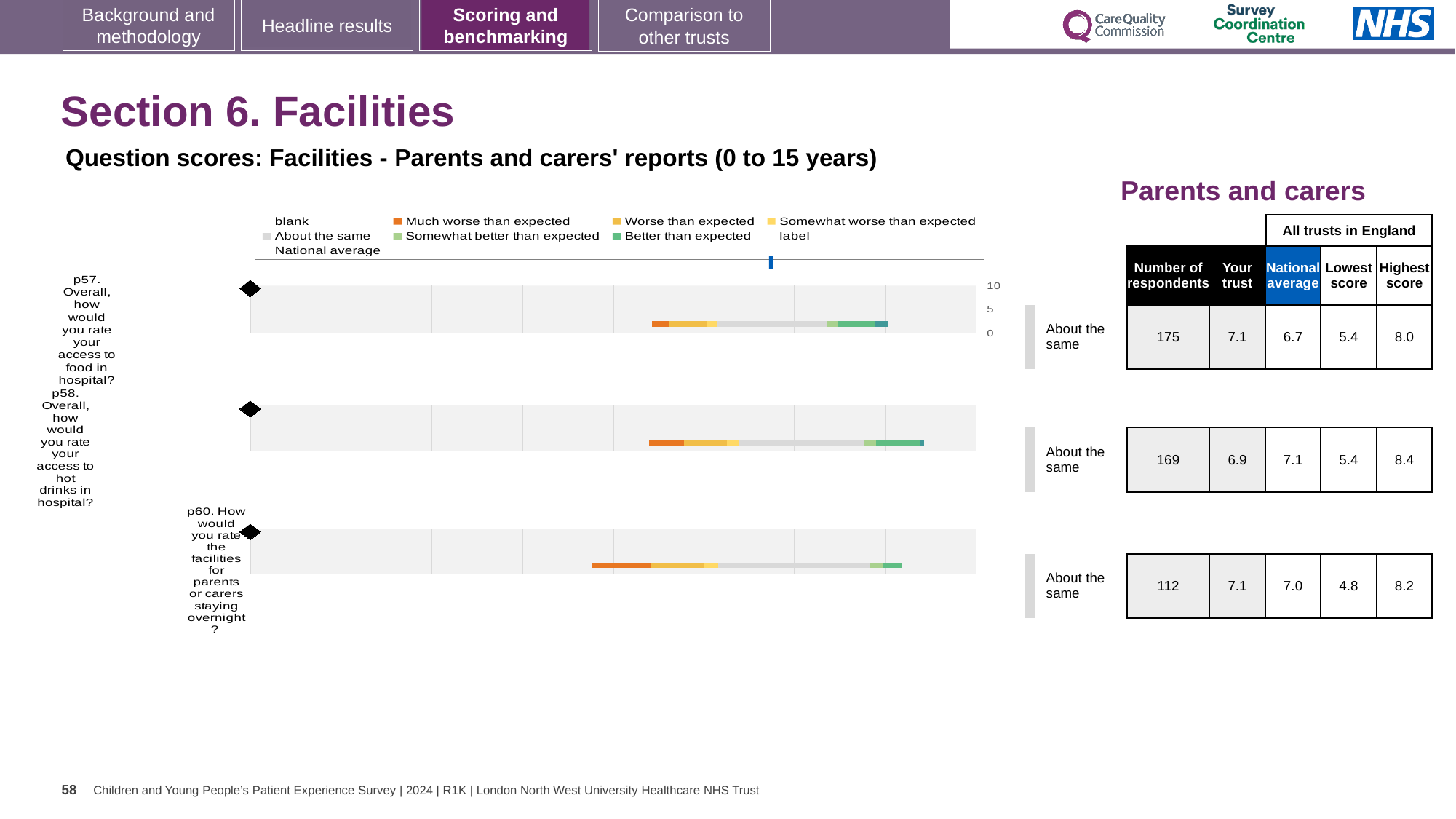
For p58, what is the difference between the highest score (8.4) and the lowest score (5.4)? 3.0 For p60, what is the lowest score among all trusts in England? 4.8 For p57, which is larger: the 'Your trust' score or the national average? Your trust For p58, what is the highest score among all trusts in England? 8.4 For p60 (facilities for parents or carers staying overnight), what is the national average score? 7.0 For p58 (access to hot drinks in hospital), what is the 'Your trust' score? 6.9 Which question has the highest number of respondents? p57 What benchmark category is shown next to the p60 chart? About the same How many questions (chart rows) are shown on the slide? 3 What kind of chart is used to show the question scores for p57, p58 and p60? Bar chart What colour represents 'Much worse than expected' in the legend? Orange For p57 (access to food in hospital), how many respondents are shown in the table? 175